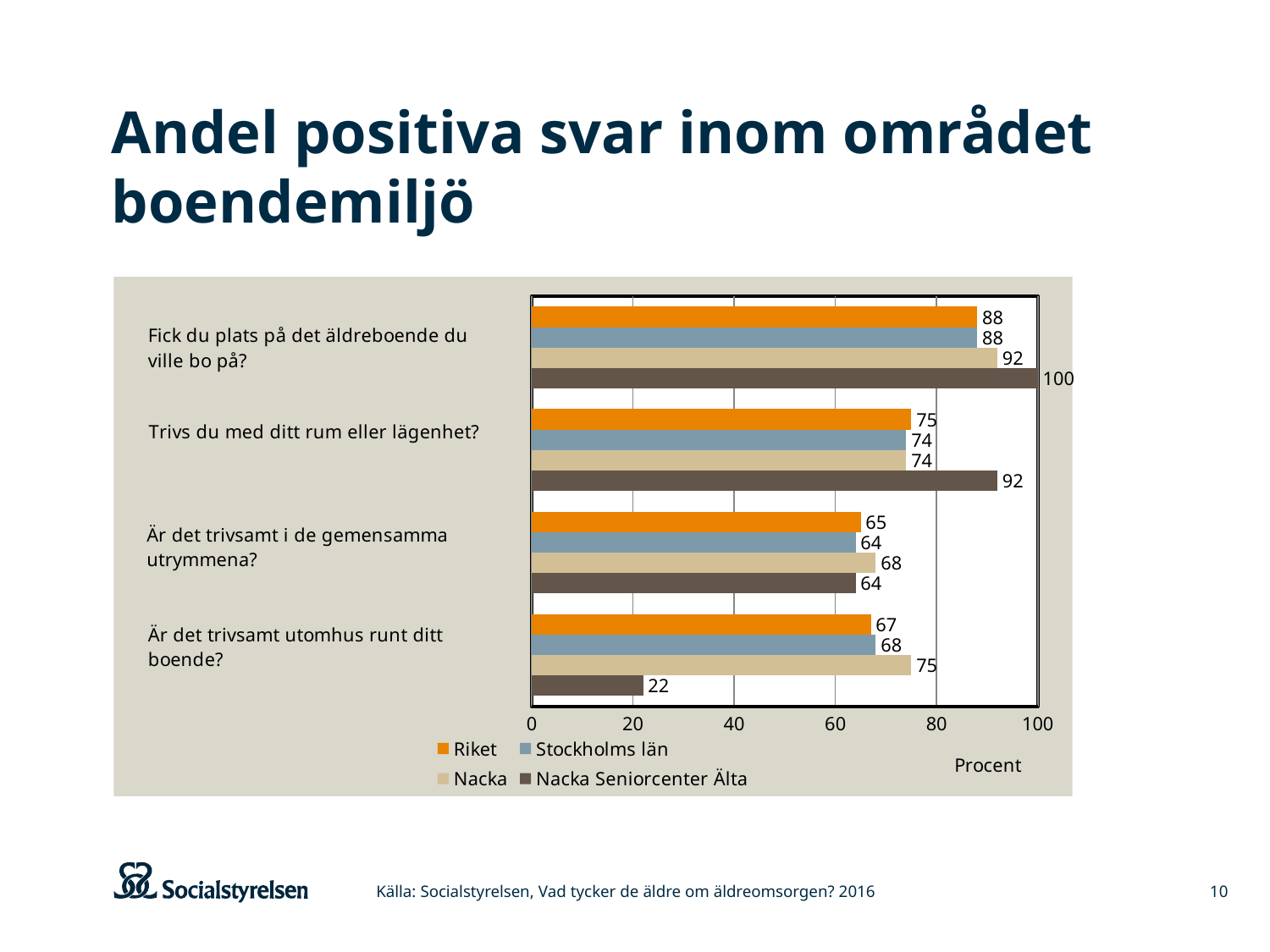
Which series has the lowest value on "Är det trivsamt utomhus runt ditt boende?"? Nacka Seniorcenter Älta Which is larger on "Är det trivsamt utomhus runt ditt boende?": Riket or Nacka? Nacka What is the difference between Nacka Seniorcenter Älta and Nacka on "Trivs du med ditt rum eller lägenhet?"? 18 What is the value for Nacka Seniorcenter Älta on "Är det trivsamt utomhus runt ditt boende?"? 22 What kind of chart is shown on the slide? Bar chart How many question categories are shown on the chart? 4 What is the value for Nacka Seniorcenter Älta on "Fick du plats på det äldreboende du ville bo på?"? 100 Which series has the highest value on "Trivs du med ditt rum eller lägenhet?"? Nacka Seniorcenter Älta What is the label of the horizontal axis? Procent How many series does the legend list? 4 What is the value for Riket on "Trivs du med ditt rum eller lägenhet?"? 75 What is the value for Nacka on "Är det trivsamt i de gemensamma utrymmena?"? 68